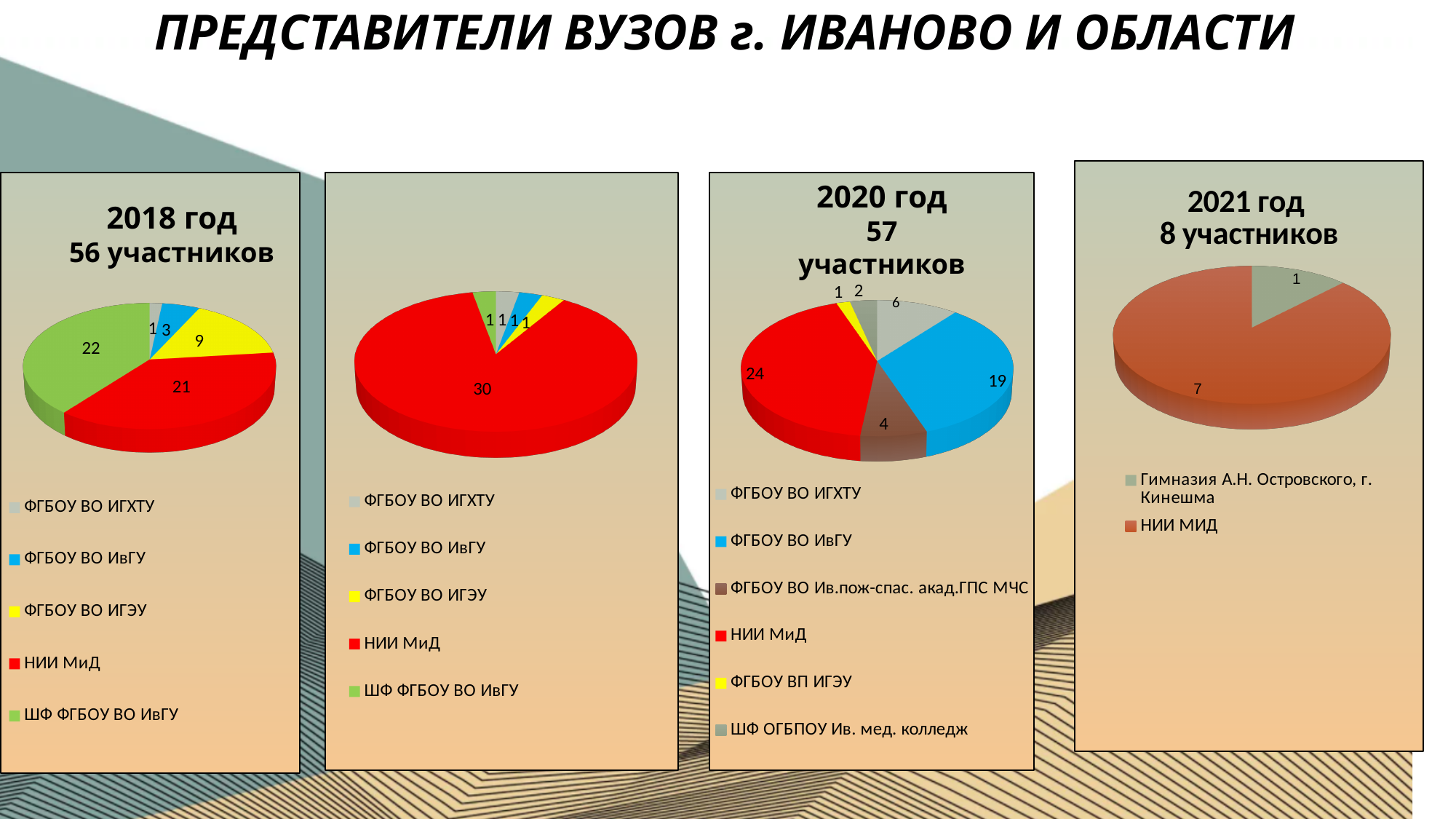
In the 2020 год chart, what is the difference between the ФГБОУ ВО ИГХТУ value and the ФГБОУ ВО Ив.пож-спас. акад.ГПС МЧС value? 2 In the 2021 год chart, what share of the pie does НИИ МИД represent? 87.5% How many categories does the legend of the second chart from the left list? 5 In the 2018 год chart, which category has the largest slice? ШФ ФГБОУ ВО ИвГУ In the 2018 год chart, which category has the smallest slice? ФГБОУ ВО ИГХТУ In the 2018 год chart, what is the difference between the ФГБОУ ВО ИГЭУ value and the ФГБОУ ВО ИвГУ value? 6 How many categories does the legend of the 2020 год chart list? 6 In the second chart from the left (the one without a year title), what is the value for НИИ МиД? 30 What type of chart is the 2021 год chart? Pie chart In the 2020 год chart, which is larger: НИИ МиД or ФГБОУ ВО ИвГУ? НИИ МиД In the 2018 год chart, how many participants are from НИИ МиД? 21 In the 2020 год chart, what is the value for ФГБОУ ВО ИвГУ? 19